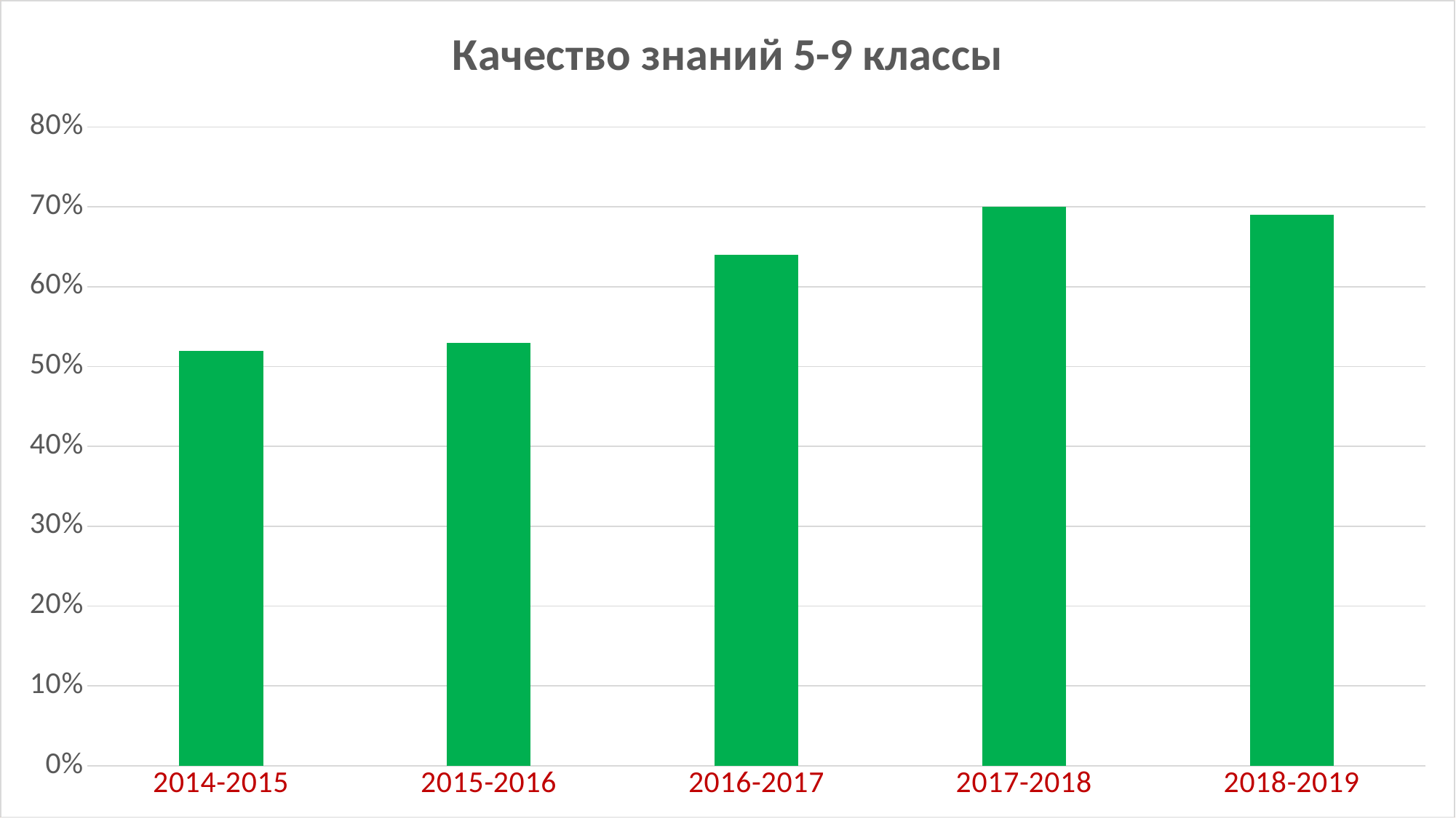
What is the title of the chart? Качество знаний 5-9 классы Is the value for 2014-2015 greater or less than 50%? greater What is the value for 2017-2018? 70% Is the value for 2016-2017 greater or less than 70%? less Is the value for 2015-2016 greater or less than 60%? less What kind of chart is shown on the slide? bar chart How many school years (categories) are shown on the x axis? 5 What colour are the bars in the chart? green Which is larger, the value for 2016-2017 or the value for 2014-2015? 2016-2017 Do the values generally rise or fall from 2014-2015 to 2017-2018? rise